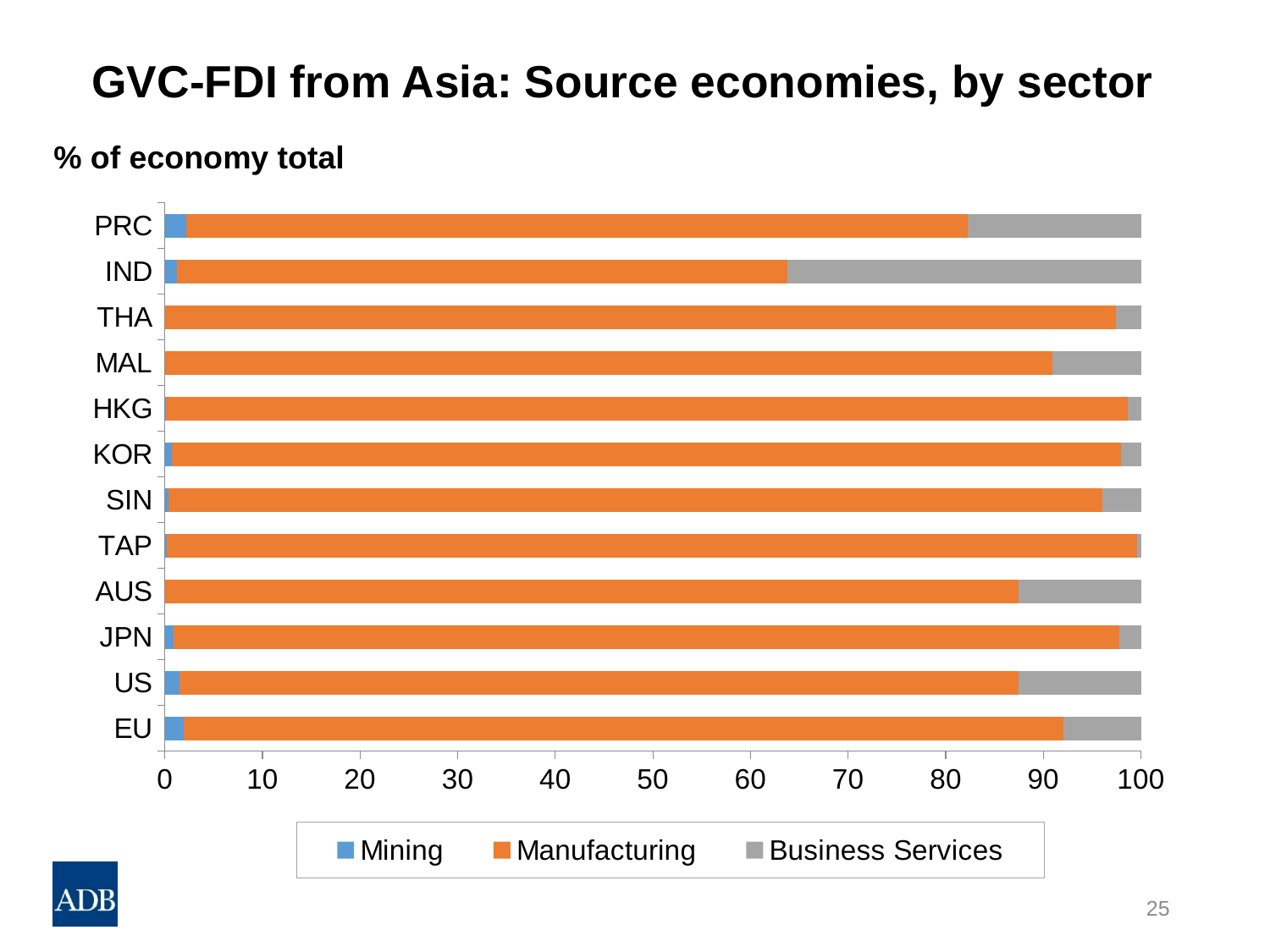
How many source economies are listed on the vertical axis of the chart? 12 Which economy has the largest Business Services share in the chart? IND How many series does the chart's legend list? 3 Which economy has the smallest Manufacturing share in the chart? IND What is the title of the chart on the slide? GVC-FDI from Asia: Source economies, by sector What kind of chart is shown on the slide? Stacked bar chart Which has the larger Business Services share, PRC or IND? IND Is the Manufacturing share for PRC greater or less than 70? greater Which has the larger Manufacturing share, THA or MAL? THA Is the Manufacturing share for IND greater or less than 70? less Is the Business Services share for IND greater or less than 30? greater What is the total of the stacked bar for PRC? 100